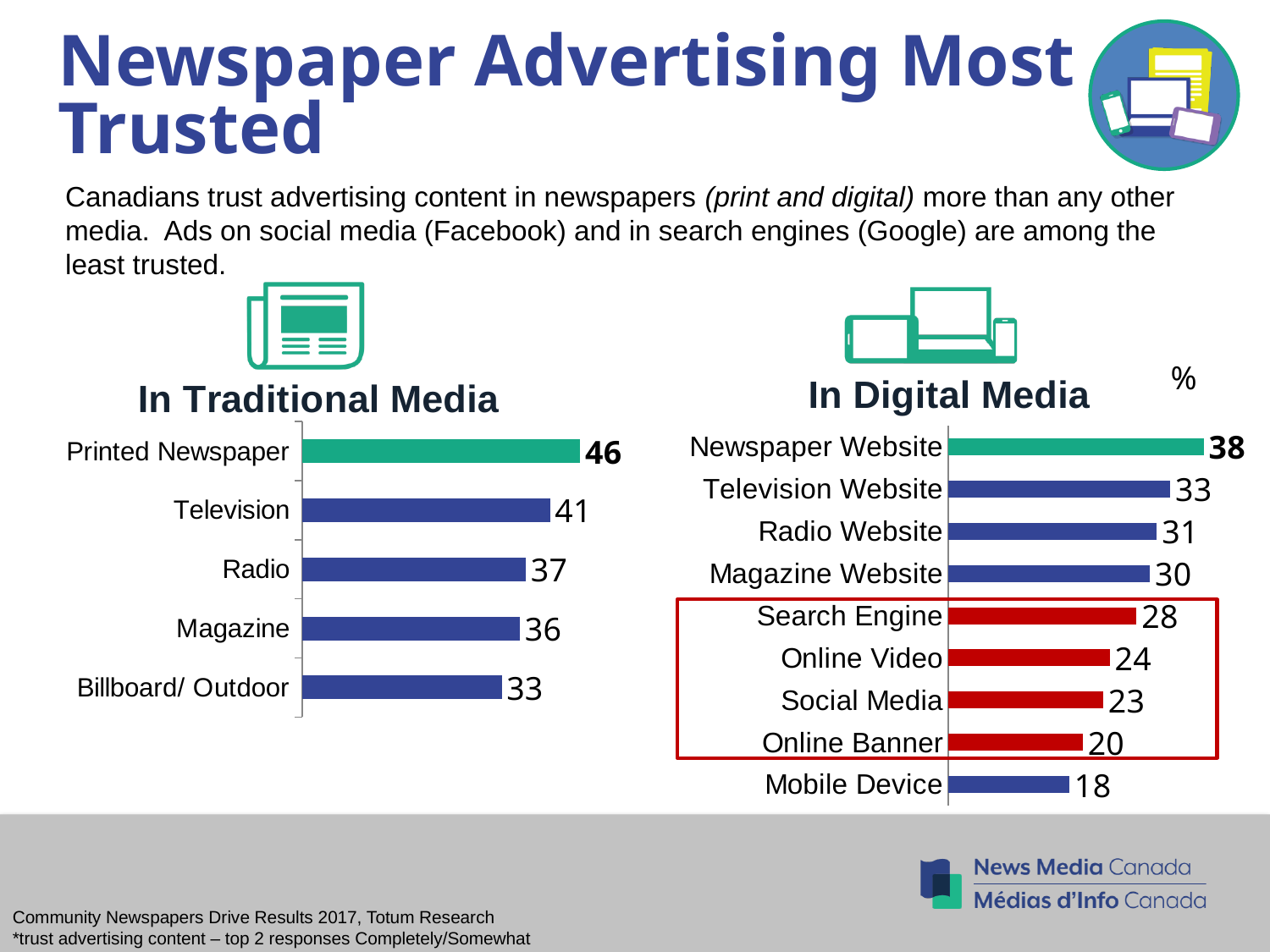
In the 'In Digital Media' chart, which categories are enclosed by the red box? Search Engine, Online Video, Social Media, Online Banner In the 'In Traditional Media' chart, which category has the highest value? Printed Newspaper In the 'In Traditional Media' chart, what is the value for Printed Newspaper? 46 In the 'In Traditional Media' chart, what is the difference between Printed Newspaper and Billboard/ Outdoor? 13 How many categories are shown in the 'In Digital Media' chart? 9 In the 'In Digital Media' chart, do the values rise or fall going from the top category to the bottom category? Fall In the 'In Digital Media' chart, which category has the lowest value? Mobile Device What kind of chart is the 'In Traditional Media' chart? Bar chart In the 'In Digital Media' chart, what is the difference between Newspaper Website and Online Banner? 18 In the 'In Digital Media' chart, which is larger, Search Engine or Online Video? Search Engine In the 'In Digital Media' chart, what is the value for Social Media? 23 How many categories are shown in the 'In Traditional Media' chart? 5